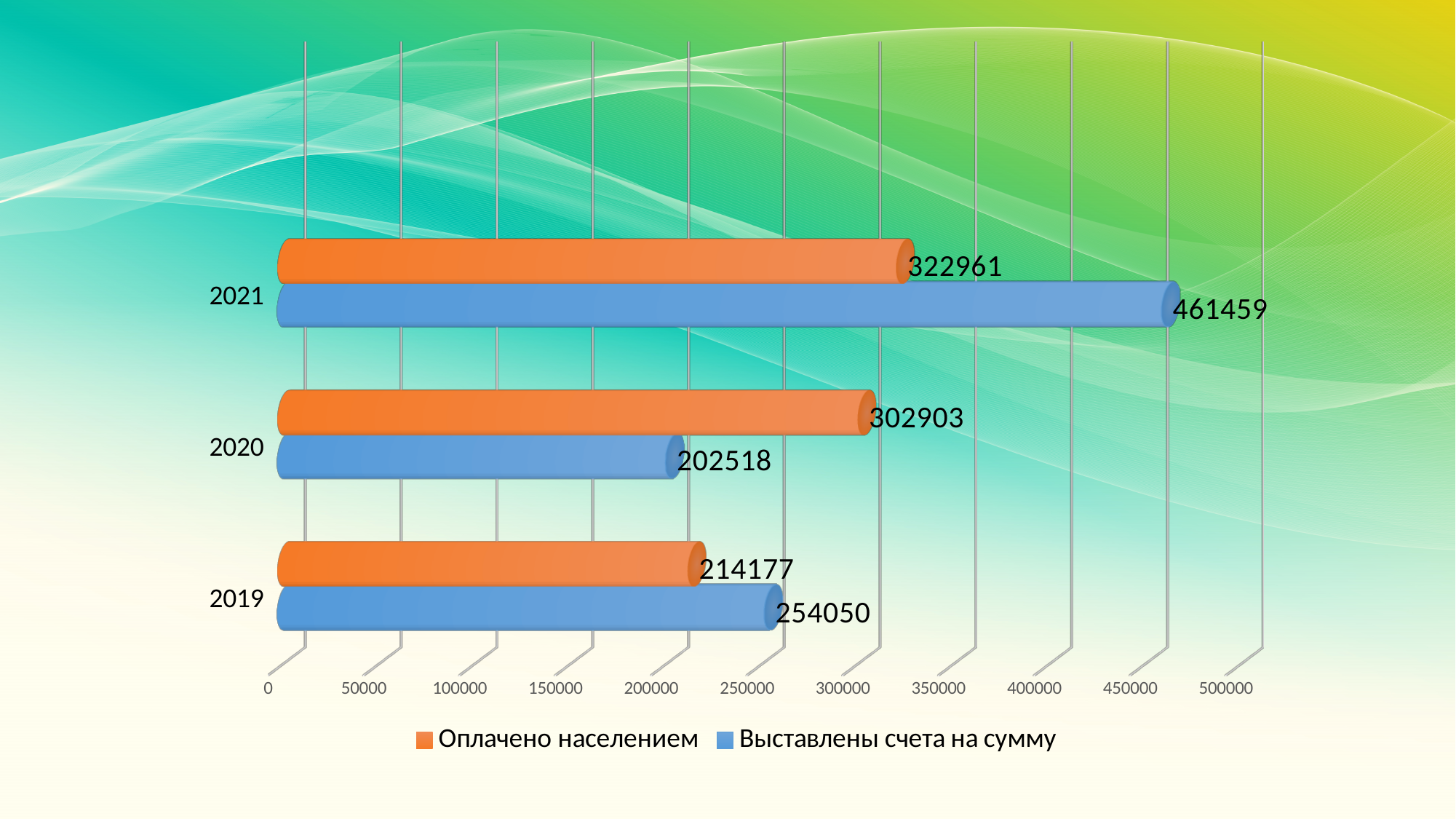
Which year has the highest value for "Выставлены счета на сумму"? 2021 What colour are the bars for "Выставлены счета на сумму"? Blue Is the value of "Оплачено населением" for 2019 greater or less than 200000? greater Which year has the lowest value for "Оплачено населением"? 2019 How many series does the legend list? 2 How many years are shown on the chart? 3 What kind of chart is shown on the slide? Bar chart In 2020, which is larger: "Оплачено населением" or "Выставлены счета на сумму"? Оплачено населением What is the difference between "Выставлены счета на сумму" and "Оплачено населением" in 2021? 138498 What is the value of "Оплачено населением" for 2021? 322961 What is the value of "Выставлены счета на сумму" for 2020? 202518 What is the value of "Выставлены счета на сумму" for 2019? 254050